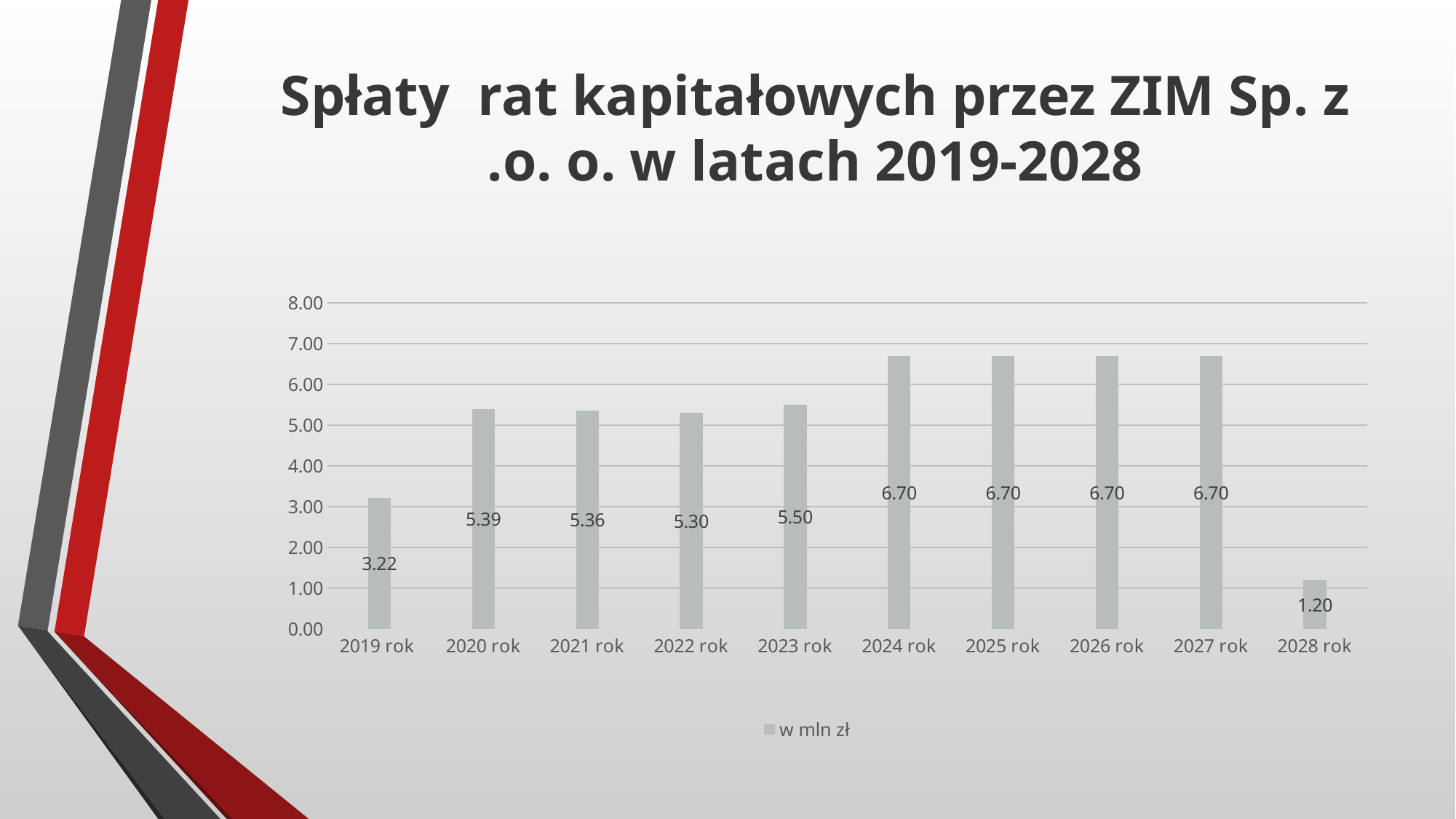
Which year has the lowest value? 2028 rok What is the value for 2019 rok? 3.22 What is the value for 2021 rok? 5.36 Which is larger, the value for 2023 rok or the value for 2022 rok? 2023 rok What is the value for 2023 rok? 5.50 What is the legend entry of the chart? w mln zł What is the difference between the values for 2020 rok and 2019 rok? 2.17 What kind of chart is shown on the slide? bar chart How many series does the legend list? 1 How many years are shown on the x axis? 10 What is the difference between the values for 2024 rok and 2028 rok? 5.50 What is the value for 2028 rok? 1.20